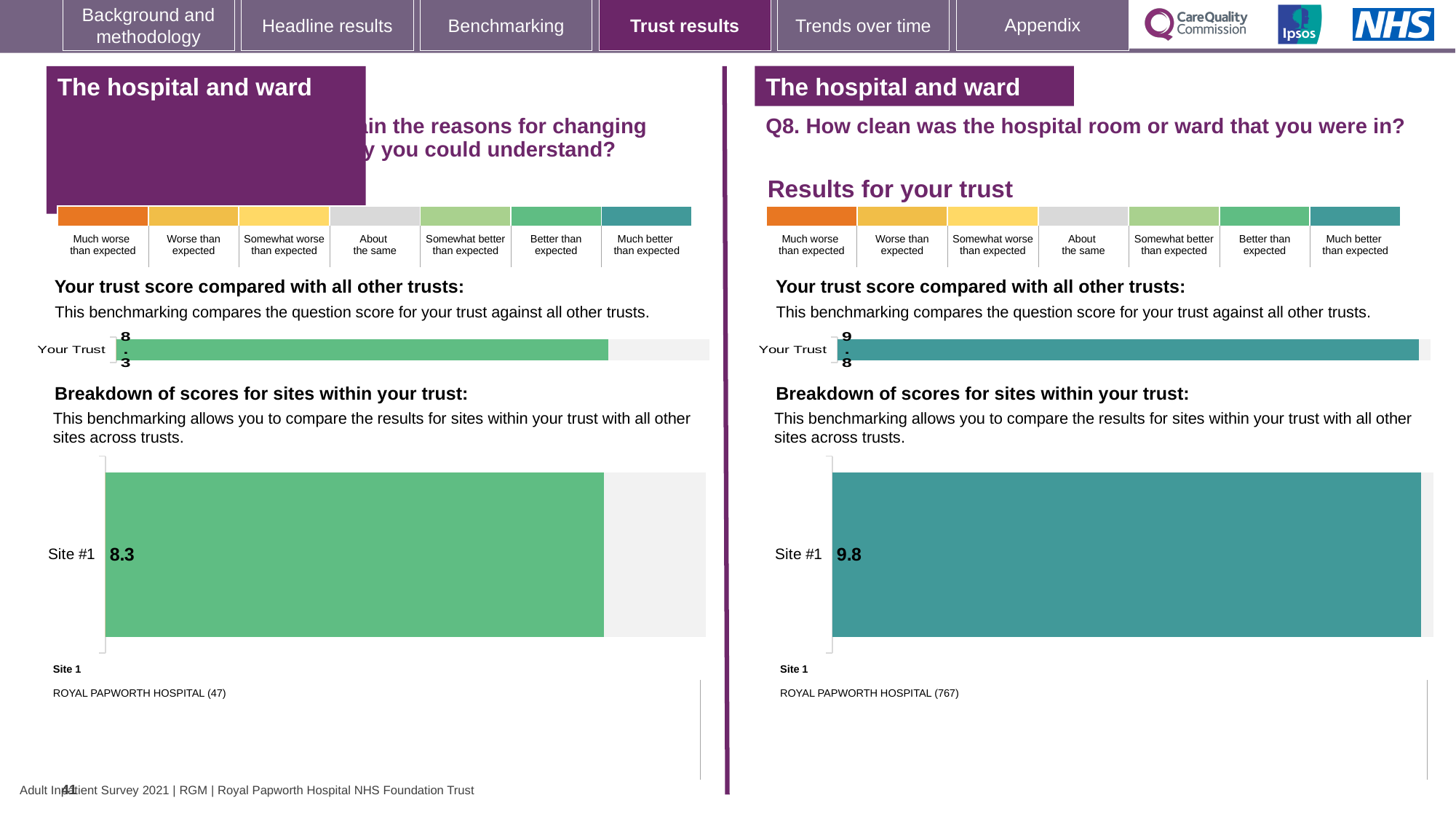
On the right-hand chart for Q8 (How clean was the hospital room or ward that you were in?), what is the score shown for Your Trust? 9.8 What is the difference between the Your Trust score on the right-hand chart for Q8 and the Your Trust score on the left-hand chart? 1.5 What is the difference between the Site #1 score on the right-hand chart for Q8 and the Site #1 score on the left-hand chart? 1.5 How many sites are shown in the breakdown of scores chart on the right-hand side for Q8? 1 On the right-hand side for Q8, which hospital is listed as Site 1? ROYAL PAPWORTH HOSPITAL (767) On the left-hand chart, what is the score shown for Site #1? 8.3 On the right-hand chart for Q8, what is the score shown for Site #1? 9.8 On the left-hand chart, what is the score shown for Your Trust? 8.3 Which is larger: the Site #1 score on the left-hand chart or the Site #1 score on the right-hand chart for Q8? Site #1 on the right-hand chart (Q8) What kind of chart is used to show the Site #1 score on the right-hand side for Q8? Bar chart On the left-hand side, which hospital is listed as Site 1? ROYAL PAPWORTH HOSPITAL (47) How many sites are shown in the breakdown of scores chart on the left-hand side? 1